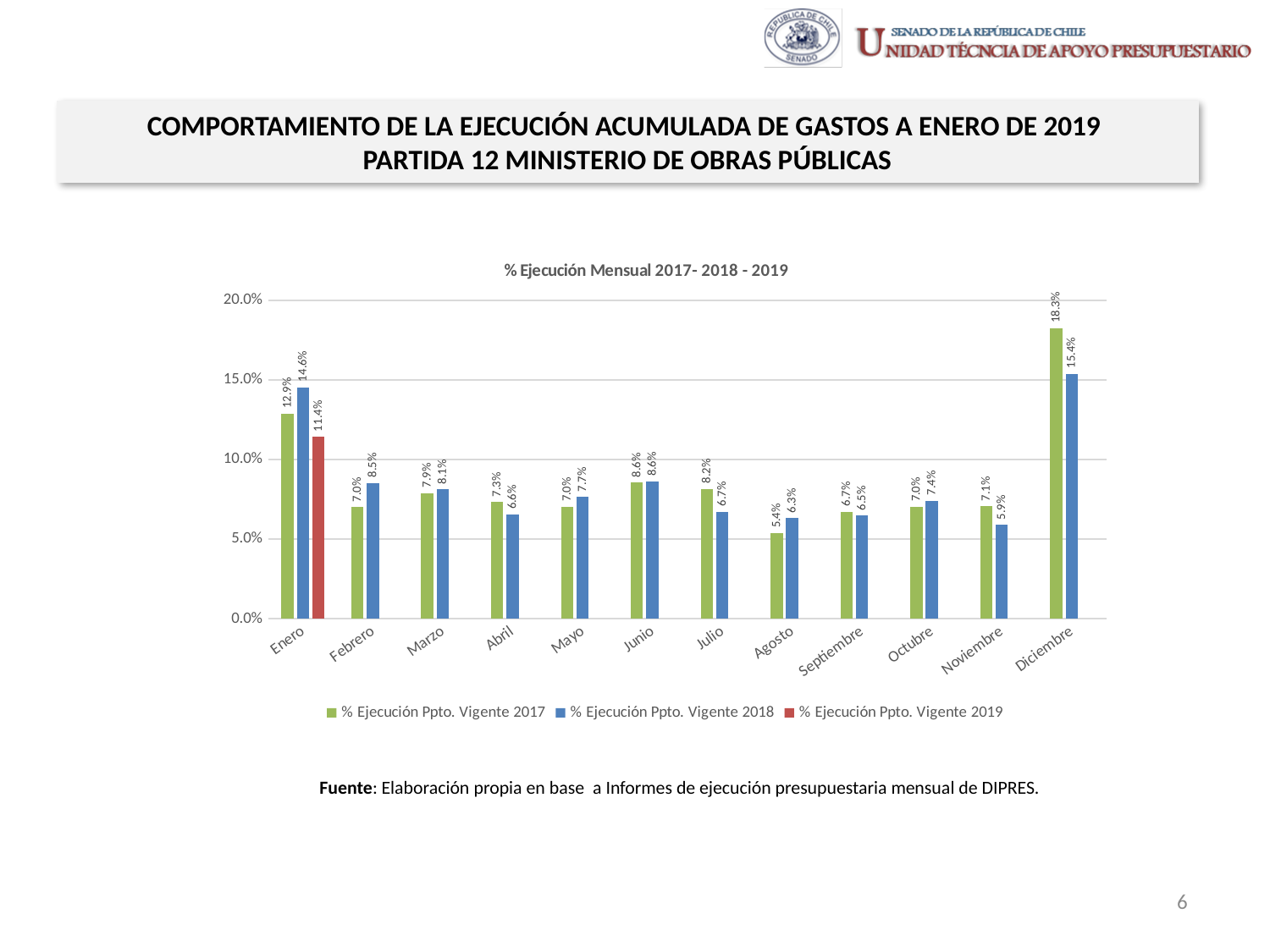
Which is larger for Noviembre: the 2017 value or the 2018 value? 2017 (7.1%) Which month has the lowest value in the % Ejecución Ppto. Vigente 2017 series? Agosto What kind of chart is shown? Bar chart Which month has the highest value in the % Ejecución Ppto. Vigente 2018 series? Diciembre How many series does the legend list? 3 Is the value for Diciembre in the 2018 series greater or less than 15.0%? greater What is the value for Diciembre in the % Ejecución Ppto. Vigente 2017 series? 18.3% What is the value for Enero in the % Ejecución Ppto. Vigente 2019 series? 11.4% What is the title of the chart? % Ejecución Mensual 2017- 2018 - 2019 How many months are shown on the x axis? 12 What is the value for Agosto in the % Ejecución Ppto. Vigente 2018 series? 6.3% What is the difference between the 2017 and 2018 values for Enero? 1.7%